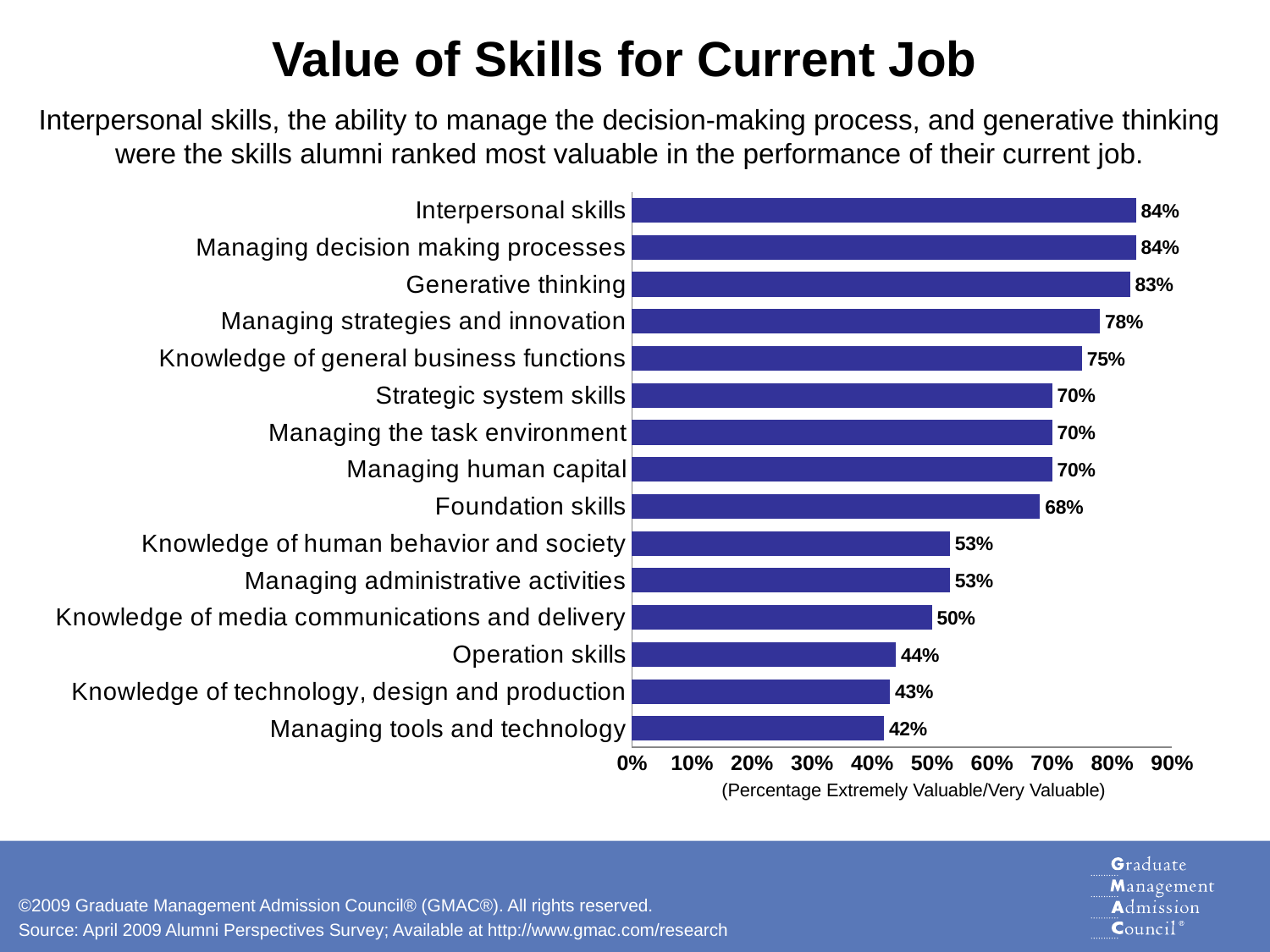
Which skill has the lowest value on the chart? Managing tools and technology Which has a higher value, Knowledge of general business functions or Strategic system skills? Knowledge of general business functions What percentage of alumni rated Generative thinking as extremely or very valuable? 83% Is the value for Managing human capital greater or less than 60%? greater What is the difference between the values for Interpersonal skills and Managing tools and technology? 42% What is the value shown for Foundation skills? 68% What is the difference between the values for Managing strategies and innovation and Operation skills? 34% What is the title of the chart on the slide? Value of Skills for Current Job Which has a higher value, Managing administrative activities or Knowledge of technology, design and production? Managing administrative activities What kind of chart is shown on the slide? Bar chart What is the value shown for Knowledge of media communications and delivery? 50% How many skills are listed on the chart? 15